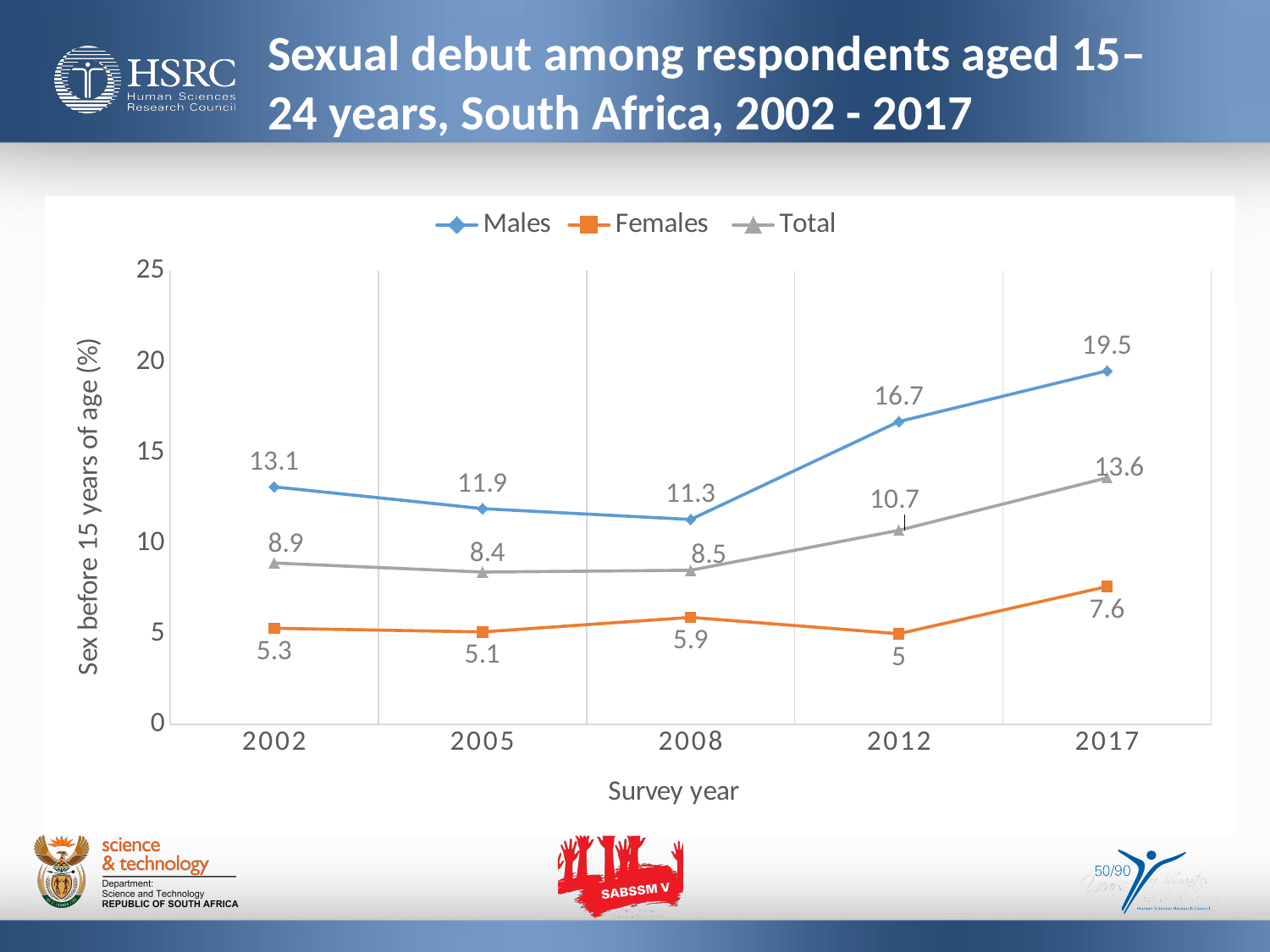
In which survey year is the Males value highest? 2017 How many series does the legend list? 3 What is the value for Total in 2012? 10.7 Is the Total value in 2017 greater or less than 10? greater What kind of chart is shown on the slide? line chart What is the value for Females in 2005? 5.1 What is the difference between the Males and Females values in 2017? 11.9 What is the value for Males in 2017? 19.5 How many survey years are shown on the x axis? 5 Which is larger in 2008: the Males value or the Total value? Males In which survey year is the Females value lowest? 2012 Does the Males value rise or fall from 2012 to 2017? rise